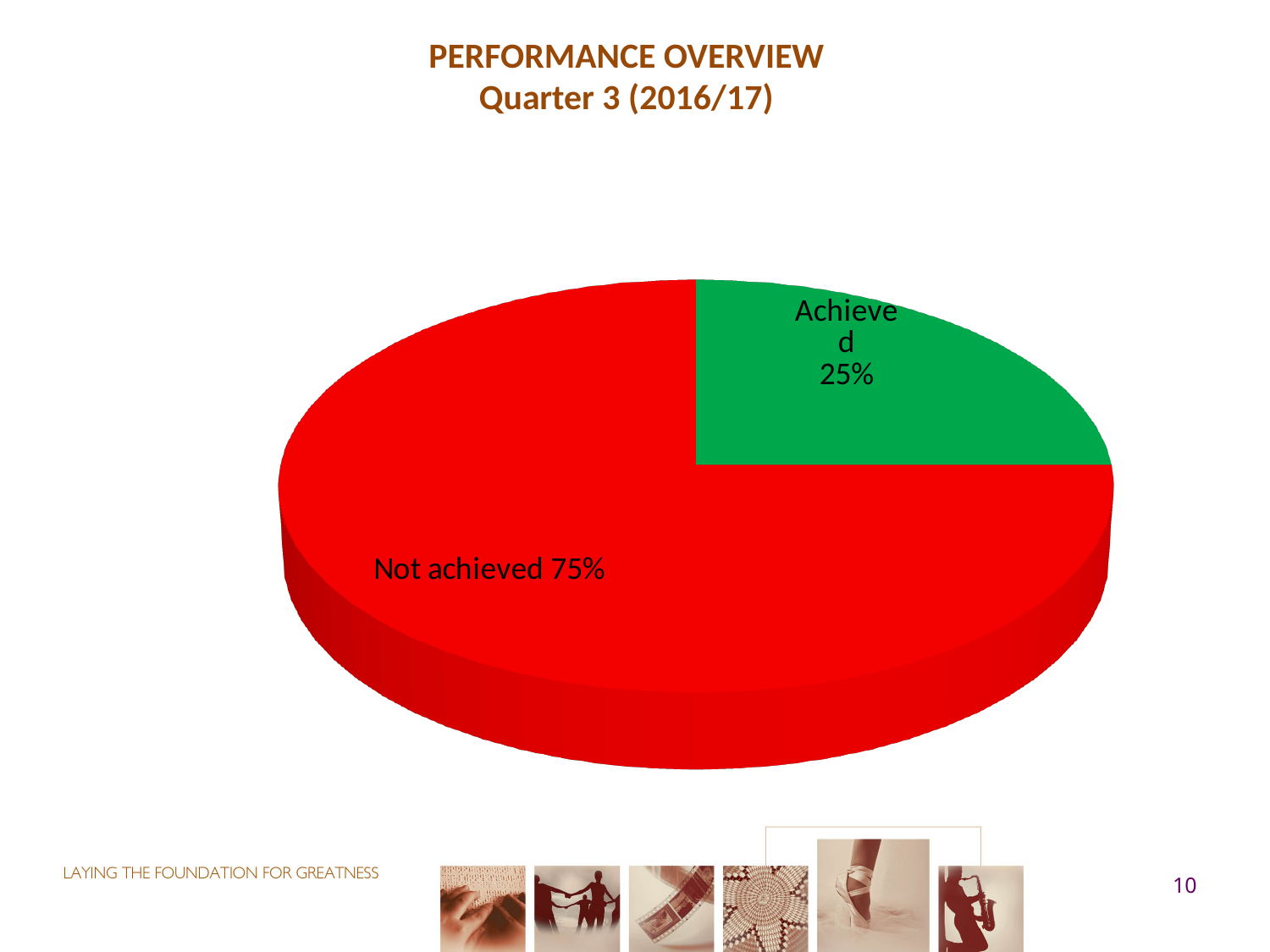
What is the difference in percentage points between the Not achieved and Achieved slices? 50 percentage points What is the title of the slide containing the chart? PERFORMANCE OVERVIEW Quarter 3 (2016/17) What share of the pie is labelled Not achieved? 75% What share of the pie is labelled Achieved? 25% How many slices does the pie chart have? 2 What kind of chart is shown on the slide? Pie chart Is the Achieved share greater or less than 50%? less Which slice of the pie is the largest? Not achieved Which is larger, the Achieved slice or the Not achieved slice? Not achieved What colour is the Not achieved slice? Red Which slice of the pie is the smallest? Achieved What is the total of the two slices shown in the pie chart? 100%